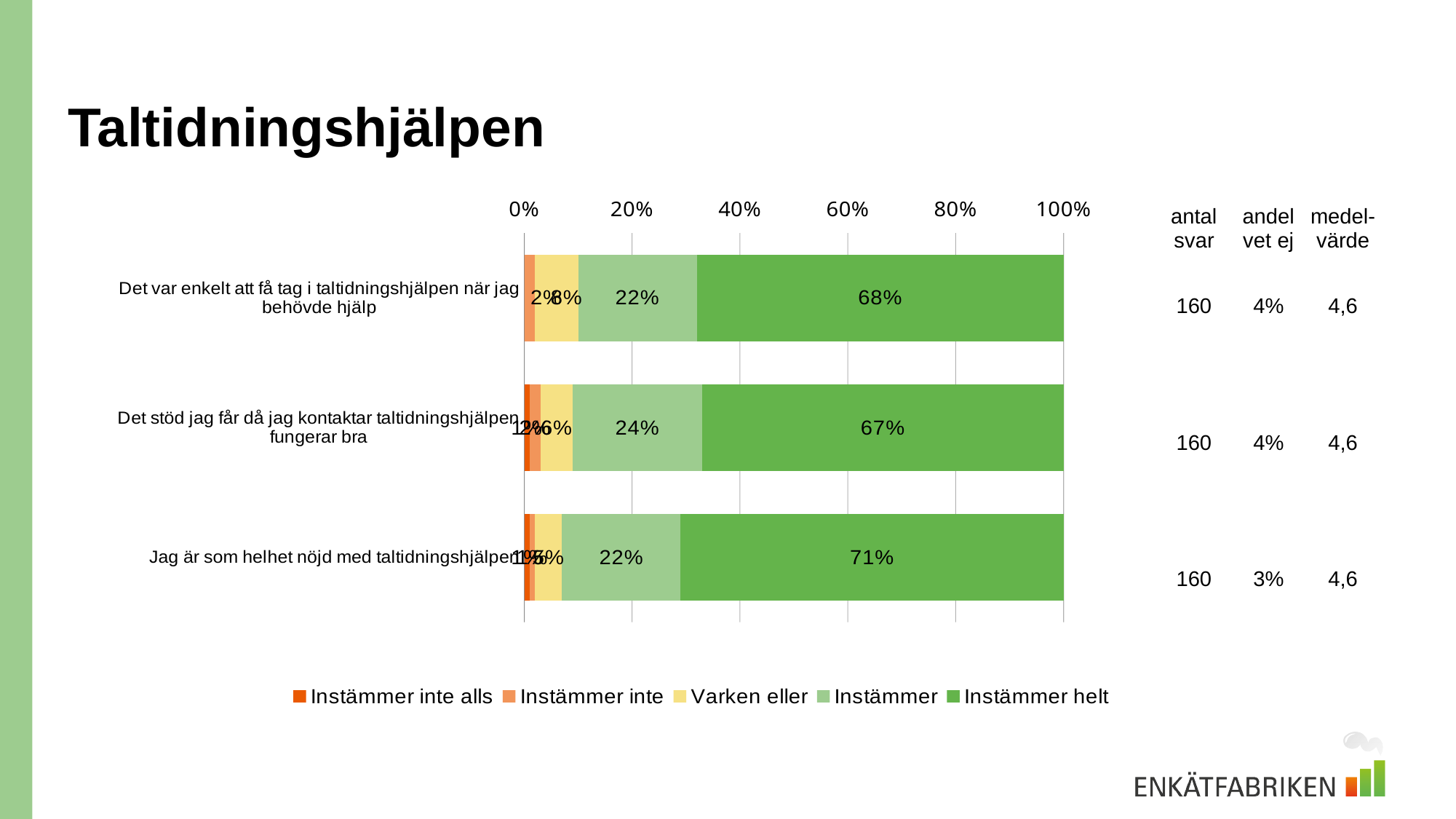
What percentage answered "Instämmer" for "Det stöd jag får då jag kontaktar taltidningshjälpen fungerar bra"? 24% What kind of chart is shown on the slide? Stacked bar chart How many statements (bars) are shown in the chart? 3 Is the "Instämmer helt" share for "Det var enkelt att få tag i taltidningshjälpen när jag behövde hjälp" greater or less than 60%? greater Which statement has the lowest share of "Instämmer helt"? Det stöd jag får då jag kontaktar taltidningshjälpen fungerar bra What is the difference in percentage points between the "Instämmer helt" share for "Jag är som helhet nöjd med taltidningshjälpen" and for "Det stöd jag får då jag kontaktar taltidningshjälpen fungerar bra"? 4 percentage points What percentage answered "Instämmer" for "Det var enkelt att få tag i taltidningshjälpen när jag behövde hjälp"? 22% What percentage answered "Instämmer helt" for "Det var enkelt att få tag i taltidningshjälpen när jag behövde hjälp"? 68% Which statement has a larger "Instämmer" share: "Det stöd jag får då jag kontaktar taltidningshjälpen fungerar bra" or "Det var enkelt att få tag i taltidningshjälpen när jag behövde hjälp"? Det stöd jag får då jag kontaktar taltidningshjälpen fungerar bra What percentage answered "Instämmer helt" for "Jag är som helhet nöjd med taltidningshjälpen"? 71% How many series does the legend list? 5 Which statement has the highest share of "Instämmer helt"? Jag är som helhet nöjd med taltidningshjälpen